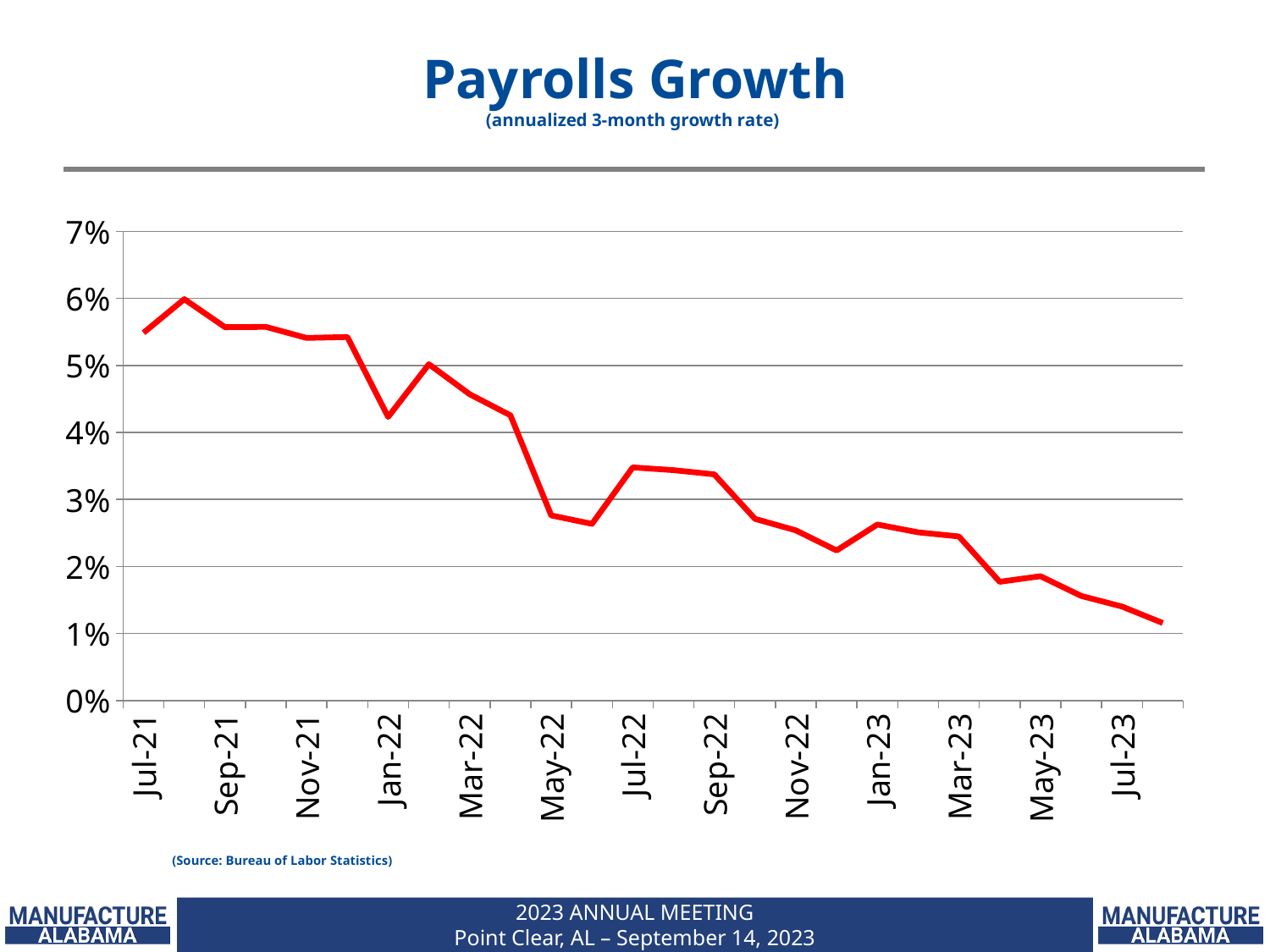
Which has the higher value, Jul-21 or Jul-23? Jul-21 How many month labels are shown on the x axis? 13 What source is cited for the chart data? Bureau of Labor Statistics Is the value for Jul-23 greater or less than 2%? less Is the value for Jul-21 greater or less than 5%? greater Is the value for Jan-22 greater or less than 5%? less What is the title of the chart? Payrolls Growth Which has the higher value, Sep-21 or Sep-22? Sep-21 What kind of chart is shown on the slide? line chart Overall, do the payroll growth values rise or fall from Jul-21 to Jul-23? fall